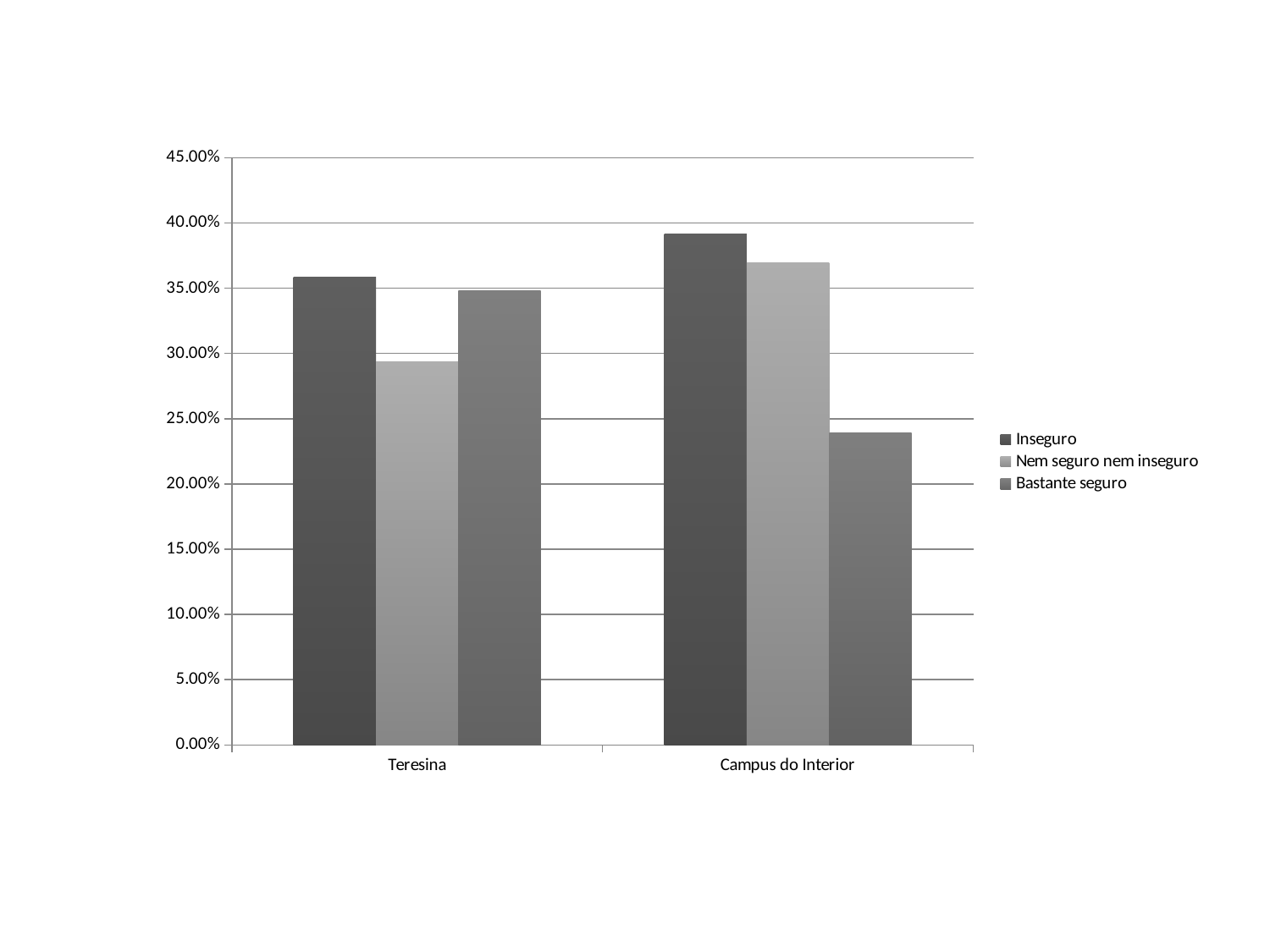
Which series has the lowest value for Campus do Interior? Bastante seguro Which is larger, the Inseguro value for Teresina or for Campus do Interior? Campus do Interior What kind of chart is shown on the slide? bar chart Which series has the highest value for Campus do Interior? Inseguro Is the value for Nem seguro nem inseguro at Teresina greater or less than 25.00%? greater How many series does the legend list? 3 Is the value for Nem seguro nem inseguro at Campus do Interior greater or less than 35.00%? greater Which series has the lowest value for Teresina? Nem seguro nem inseguro Is the value for Bastante seguro at Campus do Interior greater or less than 25.00%? less How many categories are shown on the x axis? 2 Which is larger, the Bastante seguro value for Teresina or for Campus do Interior? Teresina